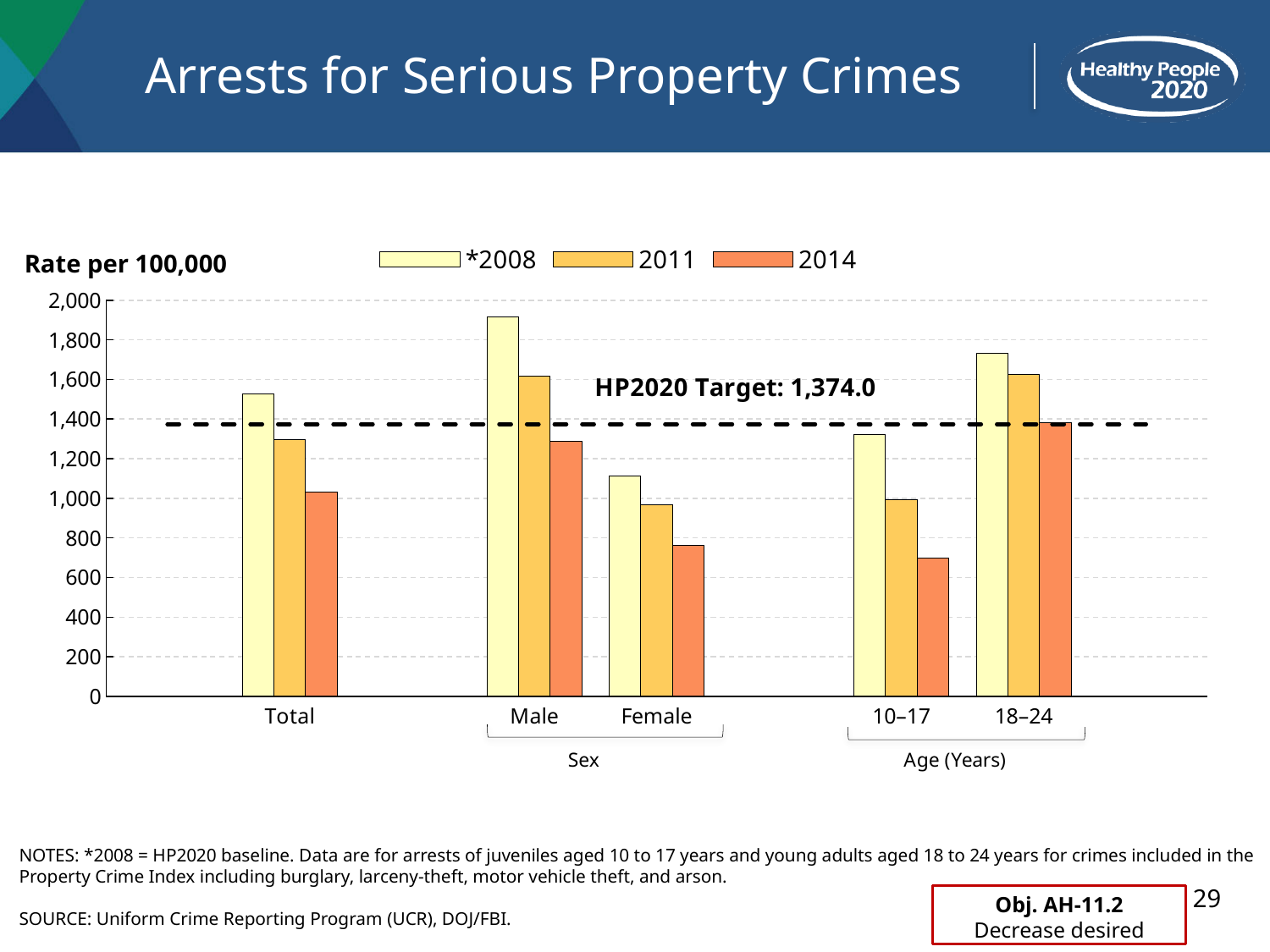
What type of chart is shown on the slide? bar chart Which category has the highest *2008 value? Male Which category has the lowest 2014 value? 10–17 What is the y-axis label of the chart? Rate per 100,000 What is the HP2020 Target value shown on the chart? 1,374.0 Which is larger, the 2011 value for Total or the 2011 value for Female? Total For the Total category, do the values rise or fall from *2008 to 2014? fall How many series does the legend list? 3 How many categories are shown along the x axis? 5 Is the *2008 value for Female greater or less than 1,000? greater Is the 2011 value for 18–24 greater or less than 1,400? greater Is the 2014 value for Male greater or less than 1,400? less